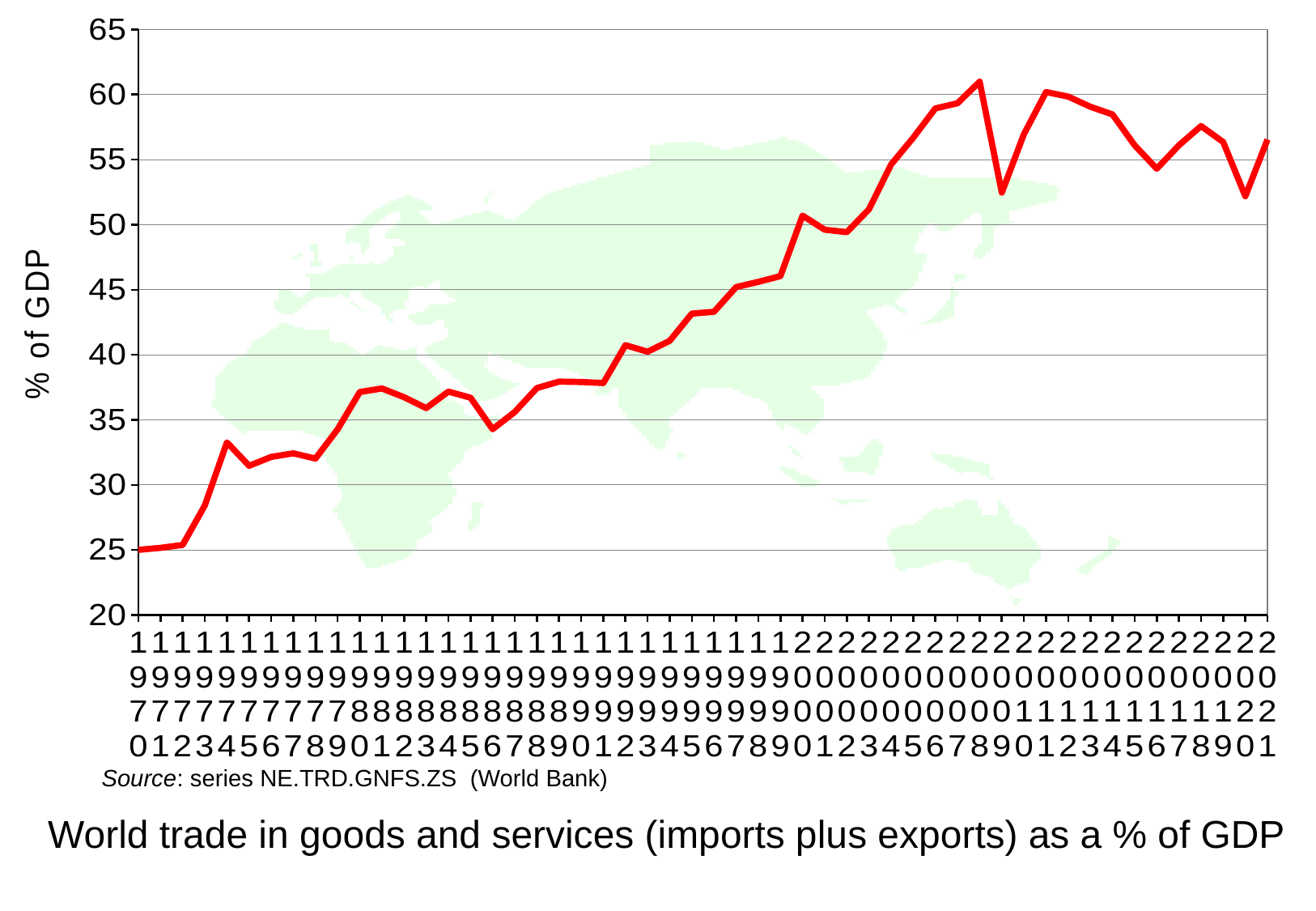
In which year does the line reach its highest value? 2008 In which year is the value lowest? 1970 What kind of chart is shown on the slide? line chart Overall, do the values rise or fall from 1970 to 2021? rise How many years (data points) are plotted along the x axis? 52 Is the value for 2008 greater or less than 55? greater Is the value for 2020 greater or less than 55? less What is the first year shown on the x axis? 1970 Which year has the larger value, 2008 or 2009? 2008 Is the value for 1970 greater or less than 30? less What is the label on the y axis? % of GDP